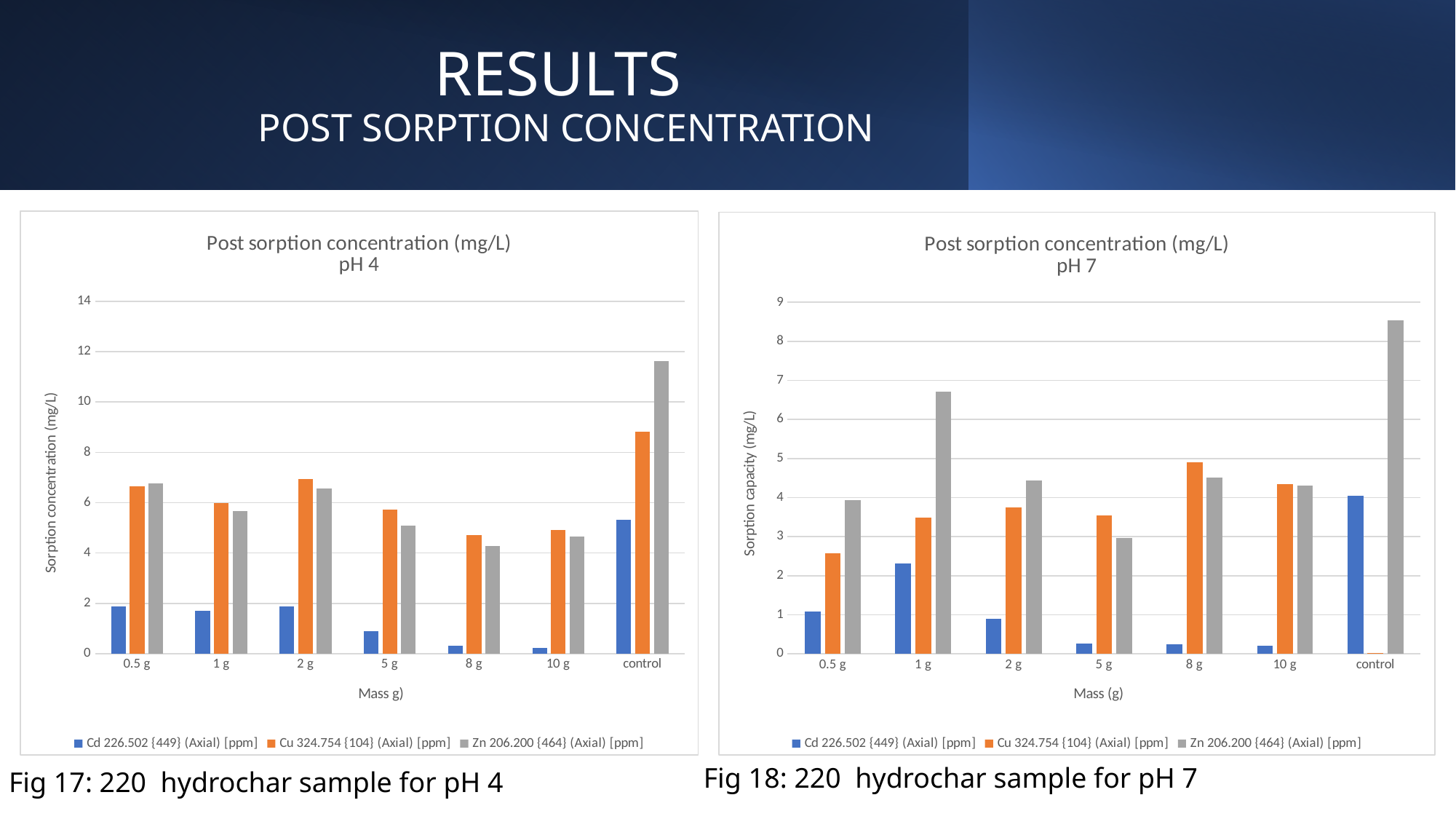
What is the x-axis title of the right chart (pH 7)? Mass (g) In the right chart (pH 7), which category has the highest Cu 324.754 bar? 8 g In the left chart (pH 4), is the Zn 206.200 value for control greater or less than 10? greater In the right chart (pH 7), is the Zn 206.200 value for 1 g greater or less than 6? greater In the right chart (pH 7), which is larger: the Cd 226.502 value at 0.5 g or at 1 g? 1 g What kind of chart is the left chart, 'Post sorption concentration (mg/L) pH 4'? bar chart In the right chart (pH 7), do the Cd 226.502 values rise or fall from 1 g to 10 g? fall In the left chart (pH 4), how many mass categories are shown on the x axis? 7 In the left chart (pH 4), which category has the highest Zn 206.200 bar? control In the left chart (pH 4), at 5 g, which is larger: Cu 324.754 or Zn 206.200? Cu 324.754 In the right chart (pH 7), how many series does the legend list? 3 In the left chart (pH 4), is the Cu 324.754 value for control greater or less than 8? greater